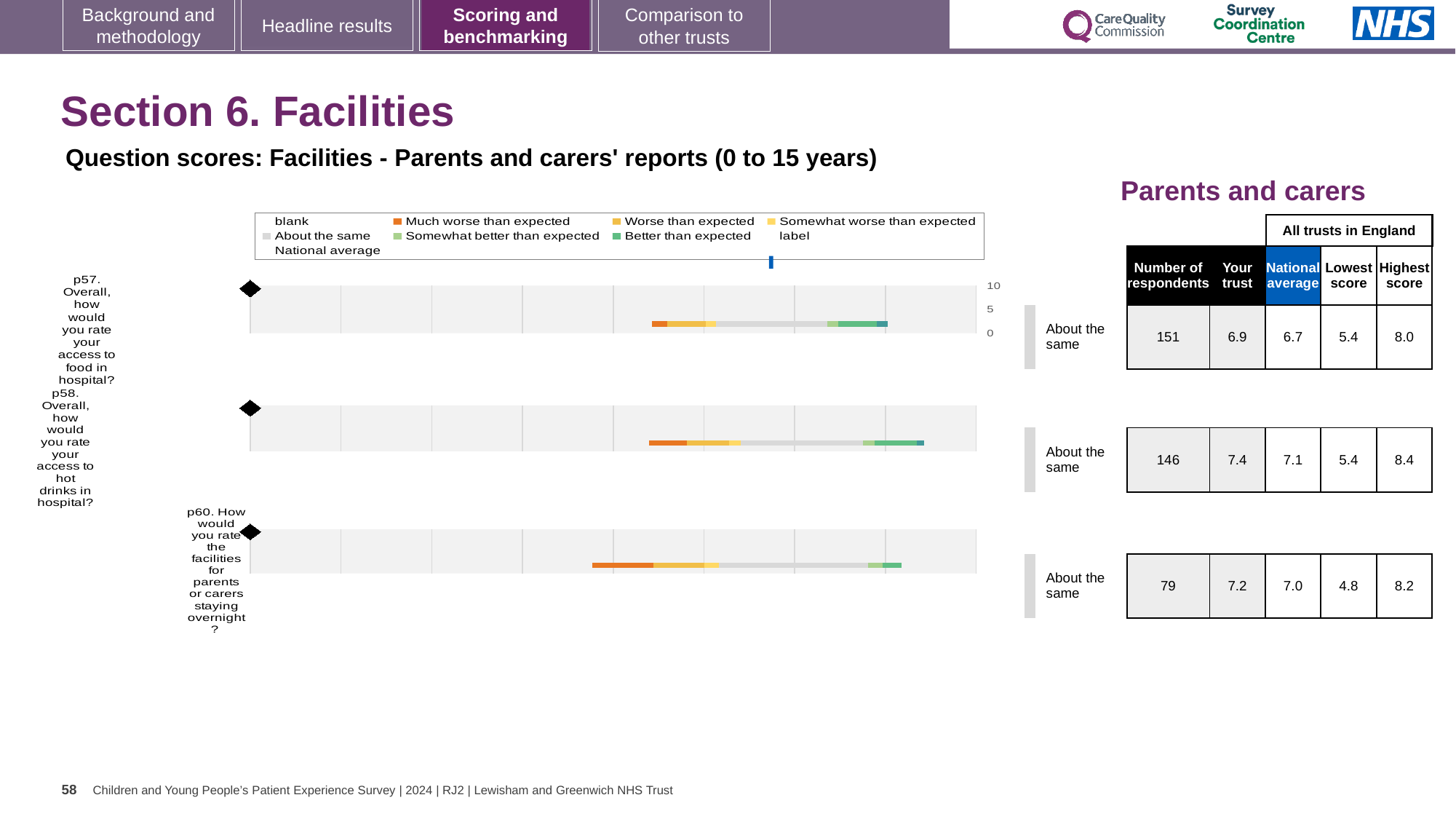
How many survey questions are plotted on the chart? 3 What kind of chart is used to show the question scores? bar chart Which question has the lowest 'Lowest score' across all trusts in England? p60 Is the 'Your trust' score for p57 higher or lower than the national average for p57? higher What is the difference between the 'Your trust' score and the national average for p58? 0.3 What is the national average for p58 (access to hot drinks in hospital)? 7.1 Which legend entry is shown in orange on the chart? Much worse than expected How many respondents answered p60 (facilities for parents or carers staying overnight)? 79 What is the highest score across all trusts in England for p58? 8.4 What is the 'Your trust' score for p57 (access to food in hospital)? 6.9 What is the highest tick value shown on the chart's axis? 10 Which of the three questions has the highest 'Your trust' score? p58